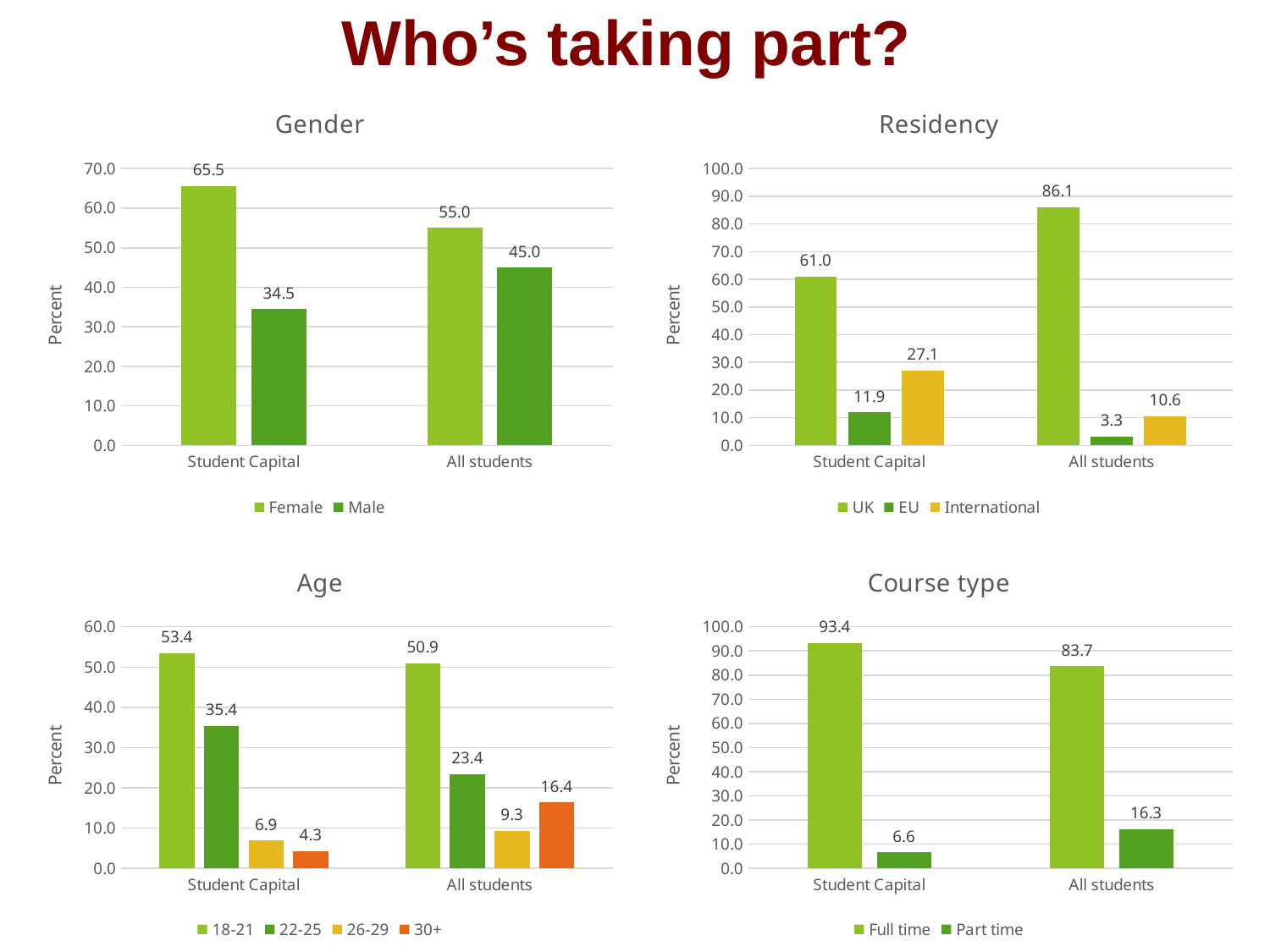
What kind of chart is the Course type chart? bar chart In the Residency chart, which residency group has the lowest value for Student Capital? EU In the Course type chart, what is the Part time value for Student Capital? 6.6 In the Age chart, what is the value for the 30+ group for All students? 16.4 In the Age chart, how many series does the legend list? 4 In the Gender chart, what is the difference between the Female and Male values for All students? 10.0 In the Gender chart, what is the Female value for Student Capital? 65.5 In the Age chart, is the 22-25 value for Student Capital larger or smaller than the 22-25 value for All students? larger In the Residency chart, what is the EU value for All students? 3.3 In the Age chart, which age group has the highest value for Student Capital? 18-21 In the Residency chart, how many series does the legend list? 3 In the Course type chart, what is the difference between the Full time values for Student Capital and All students? 9.7